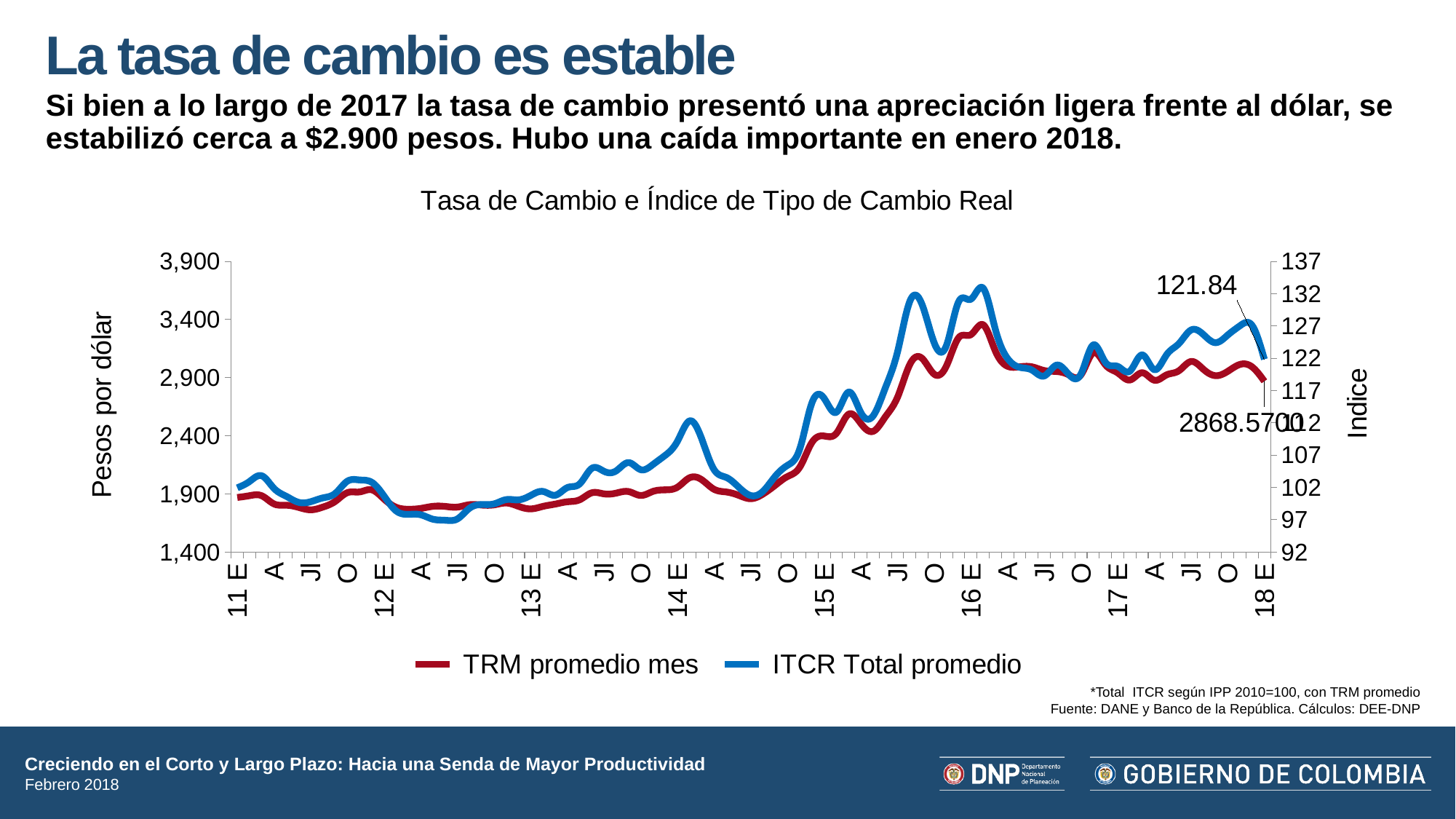
What is the title of the chart? Tasa de Cambio e Índice de Tipo de Cambio Real Is the value for TRM promedio mes at 11 E greater or less than 2,400? less Is the value for TRM promedio mes at 16 E greater or less than 2,900? greater What is the labelled value of TRM promedio mes at 18 E? 2868.5700 What kind of chart is shown on the slide? line chart What is the labelled value of ITCR Total promedio at 18 E? 121.84 Is the value for TRM promedio mes at 14 E greater or less than 2,400? less What is the label of the left vertical axis? Pesos por dólar Overall, does the TRM promedio mes line rise or fall from 11 E to 18 E? rise How many series does the legend list? 2